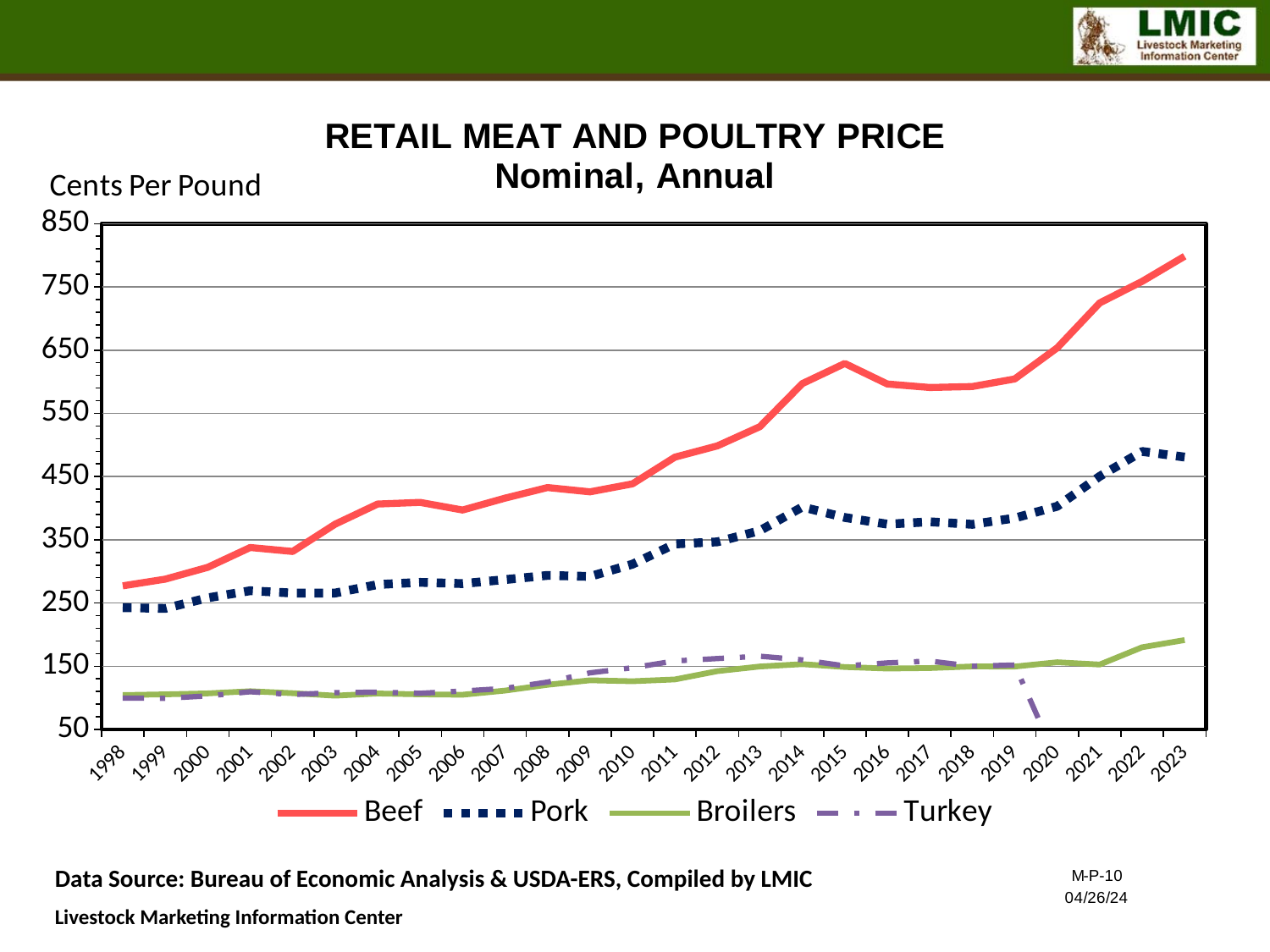
What kind of chart is shown on the slide? line chart Is the value for Beef in 1998 greater or less than 350? less Does the Beef line generally rise or fall from 1998 to 2023? rise Which series has the highest value in 2023? Beef Is the value for Beef in 2023 greater or less than 750? greater How many series does the legend list? 4 Which is larger in 2015, the value for Pork or the value for Broilers? Pork Is the value for Broilers in 2023 greater or less than 150? greater Which series has the lowest value in 2023? Broilers What unit is shown for the y axis? Cents Per Pound How many years are shown along the x axis? 26